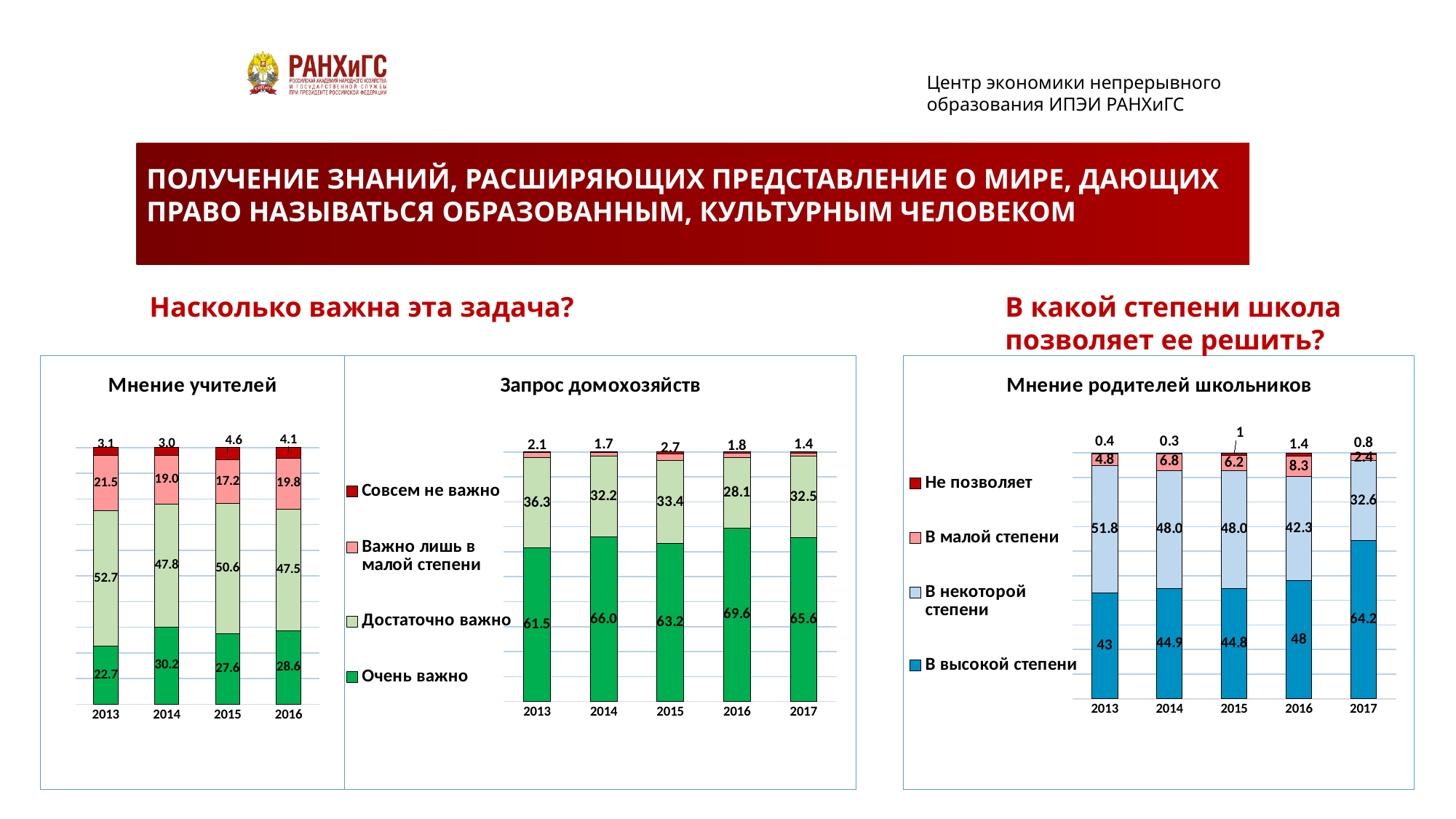
What kind of chart is 'Мнение родителей школьников'? Stacked bar chart In the 'Мнение учителей' chart, which year has the lowest value for 'Очень важно'? 2013 In the 'Мнение учителей' chart, what is the value for 'Очень важно' in 2015? 27.6 In the 'Запрос домохозяйств' chart, which year has the highest value for 'Очень важно'? 2016 In the 'Мнение родителей школьников' chart, what is the value for 'В высокой степени' in 2017? 64.2 How many years are shown on the x axis of the 'Запрос домохозяйств' chart? 5 How many series does the legend of the 'Мнение родителей школьников' chart list? 4 In the 'Мнение учителей' chart, which year has the larger value for 'Достаточно важно', 2013 or 2014? 2013 In the 'Мнение родителей школьников' chart, by how much does 'В высокой степени' in 2017 exceed 2016? 16.2 In the 'Мнение родителей школьников' chart, does the value for 'В некоторой степени' rise or fall from 2013 to 2017? Fall In the 'Мнение учителей' chart, what is the total of the stacked bar for 2013? 100.0 In the 'Запрос домохозяйств' chart, what is the value for 'Очень важно' in 2016? 69.6